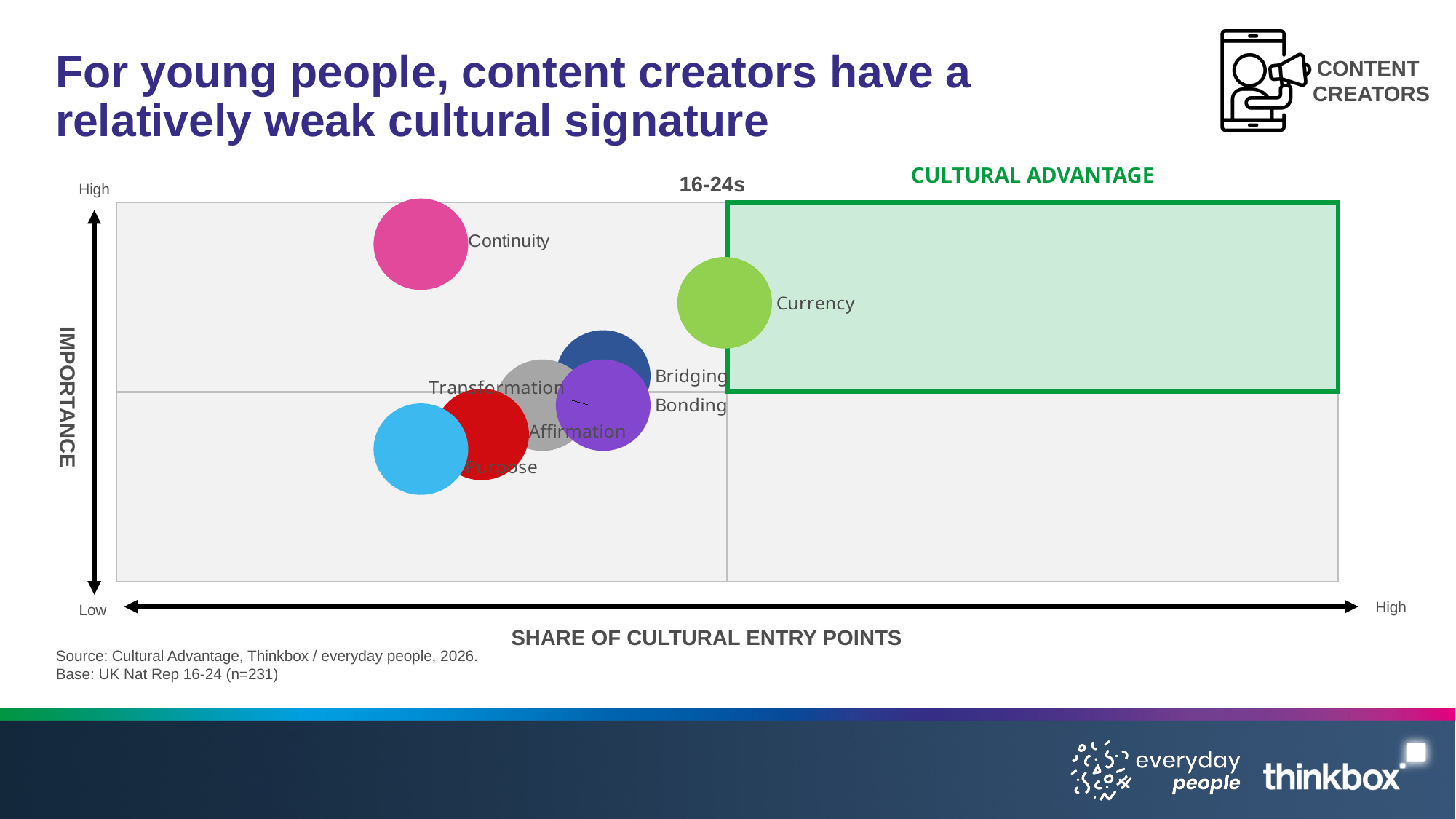
Which is further right on the Share of Cultural Entry Points axis, Bonding or Continuity? Bonding What kind of chart is shown on the slide? Bubble chart Which bubble is positioned highest on the Importance axis? Continuity Which age group does the chart cover, according to the label above it? 16-24s Which is higher on the Importance axis, Bridging or Purpose? Bridging Which is further right on the Share of Cultural Entry Points axis, Currency or Bridging? Currency What is the label of the vertical axis? IMPORTANCE Which bubble is positioned furthest right on the Share of Cultural Entry Points axis? Currency How many labelled bubbles are plotted on the chart? 7